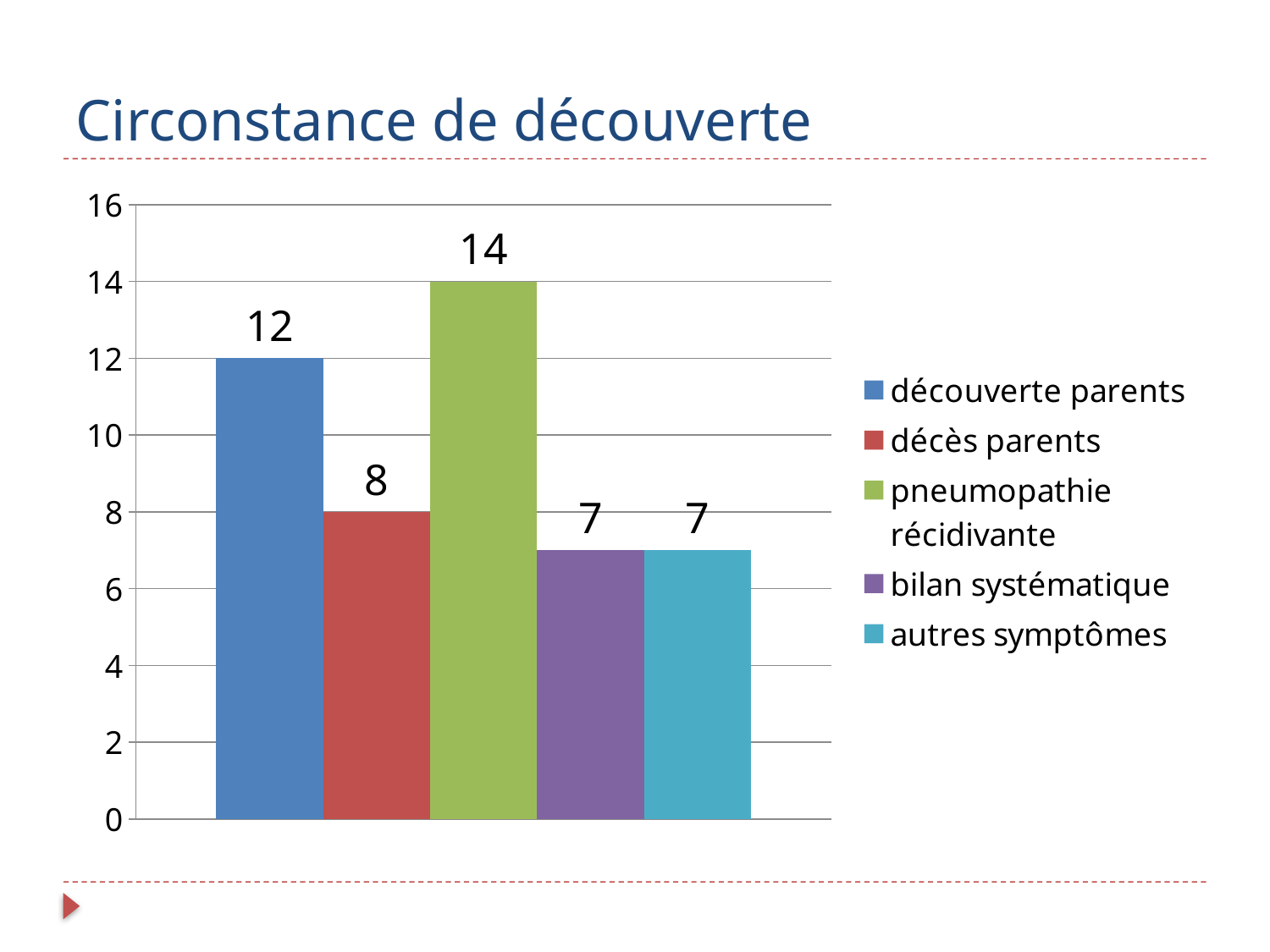
Which category has the highest value? pneumopathie récidivante What is the value for découverte parents? 12 What is the value for pneumopathie récidivante? 14 How many entries does the legend list? 5 What is the value for décès parents? 8 What is the difference between the values for pneumopathie récidivante and découverte parents? 2 What is the difference between the values for découverte parents and décès parents? 4 Which is larger, the value for décès parents or the value for autres symptômes? décès parents How many bars are shown in the chart? 5 What is the value for bilan systématique? 7 What kind of chart is shown on the slide? bar chart What is the title of the slide? Circonstance de découverte